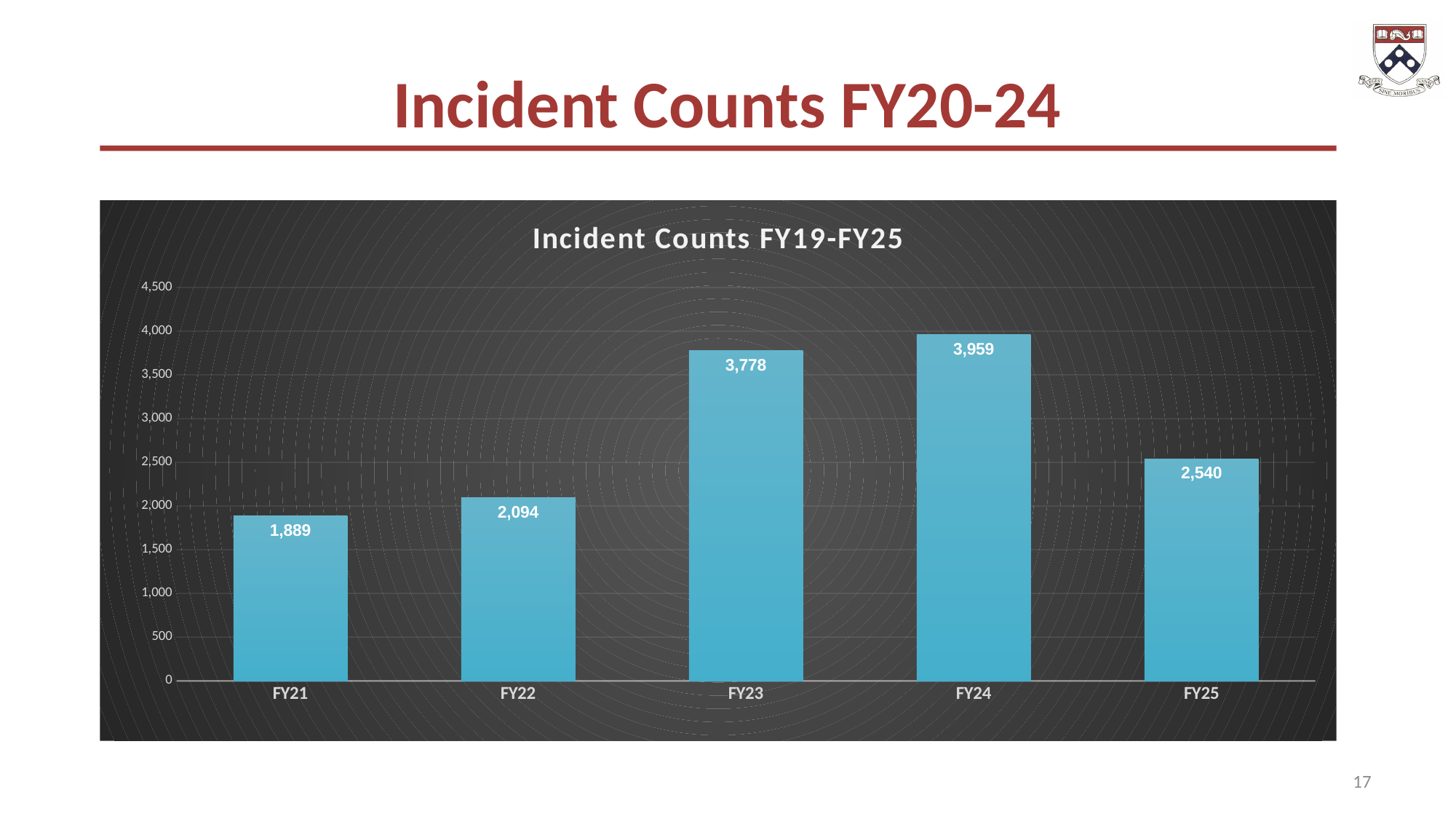
Which fiscal year has the highest incident count? FY24 What is the incident count for FY24? 3,959 What is the incident count for FY21? 1,889 What is the difference between the incident counts for FY22 and FY21? 205 Is the value for FY22 greater or less than 2,500? less What is the incident count for FY25? 2,540 What is the difference between the incident counts for FY24 and FY23? 181 What is the title shown inside the chart area? Incident Counts FY19-FY25 Which has a higher incident count, FY23 or FY25? FY23 What kind of chart is shown on the slide? bar chart Which fiscal year has the lowest incident count? FY21 How many fiscal years are shown on the chart? 5